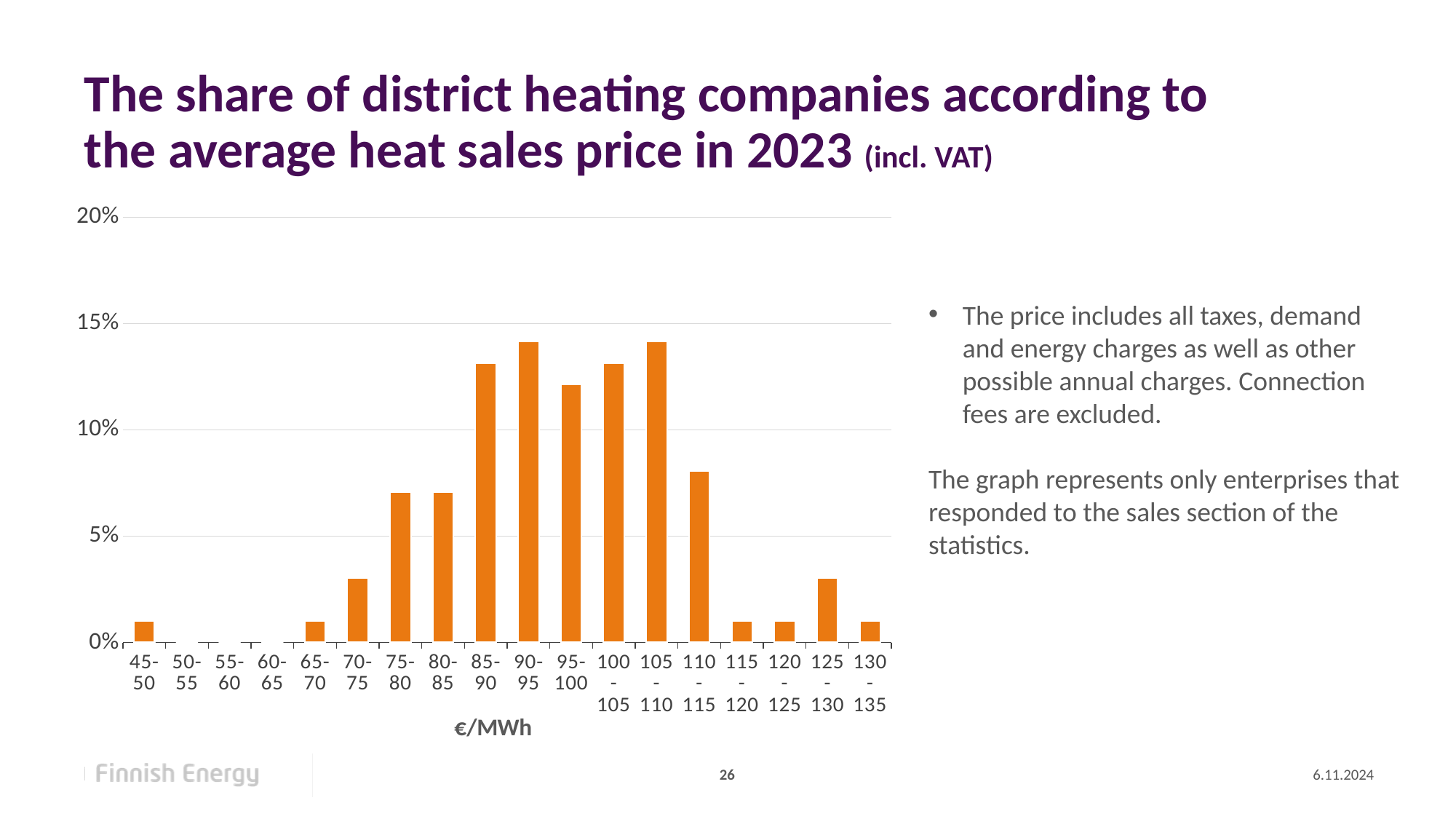
What kind of chart is shown on the slide? bar chart Is the value for the 70-75 €/MWh category greater or less than 5%? less Which has the larger share: the 85-90 €/MWh category or the 75-80 €/MWh category? 85-90 Is the value for the 125-130 €/MWh category greater or less than 5%? less How many price categories have a share of 0% in the chart? 3 What is the label of the x axis of the chart? €/MWh How many price categories are shown on the x axis of the chart? 18 Is the value for the 110-115 €/MWh category greater or less than 5%? greater What is the share for the 55-60 €/MWh category? 0% Which has the larger share: the 110-115 €/MWh category or the 70-75 €/MWh category? 110-115